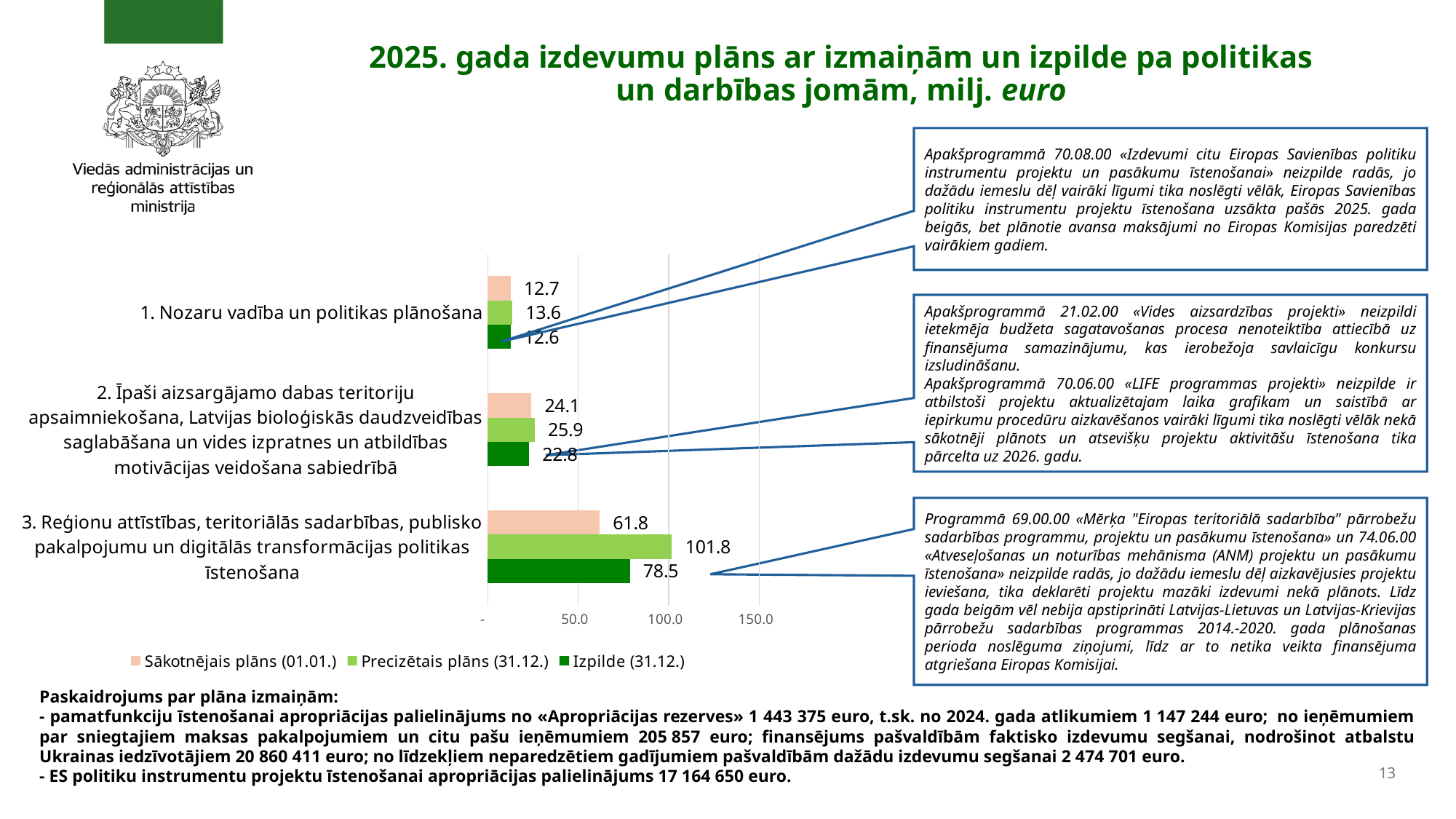
What is the value of Precizētais plāns (31.12.) for category 3 (Reģionu attīstības, teritoriālās sadarbības, publisko pakalpojumu un digitālās transformācijas politikas īstenošana)? 101.8 What colour represents the Izpilde (31.12.) series in the chart? dark green How many categories (policy areas) are plotted on the chart? 3 What kind of chart is shown on the slide? bar chart What is the value of Sākotnējais plāns (01.01.) for category 2 (Īpaši aizsargājamo dabas teritoriju apsaimniekošana...)? 24.1 What is the value of Izpilde (31.12.) for category 1 (Nozaru vadība un politikas plānošana)? 12.6 How many series does the chart legend list? 3 Is the Precizētais plāns (31.12.) value for category 3 greater or less than 100.0? greater What is the difference between Precizētais plāns (31.12.) and Izpilde (31.12.) for category 3? 23.3 Which category has the highest Izpilde (31.12.) value? 3. Reģionu attīstības, teritoriālās sadarbības, publisko pakalpojumu un digitālās transformācijas politikas īstenošana For category 2, which is larger: Precizētais plāns (31.12.) or Izpilde (31.12.)? Precizētais plāns (31.12.) Which category has the lowest Sākotnējais plāns (01.01.) value? 1. Nozaru vadība un politikas plānošana